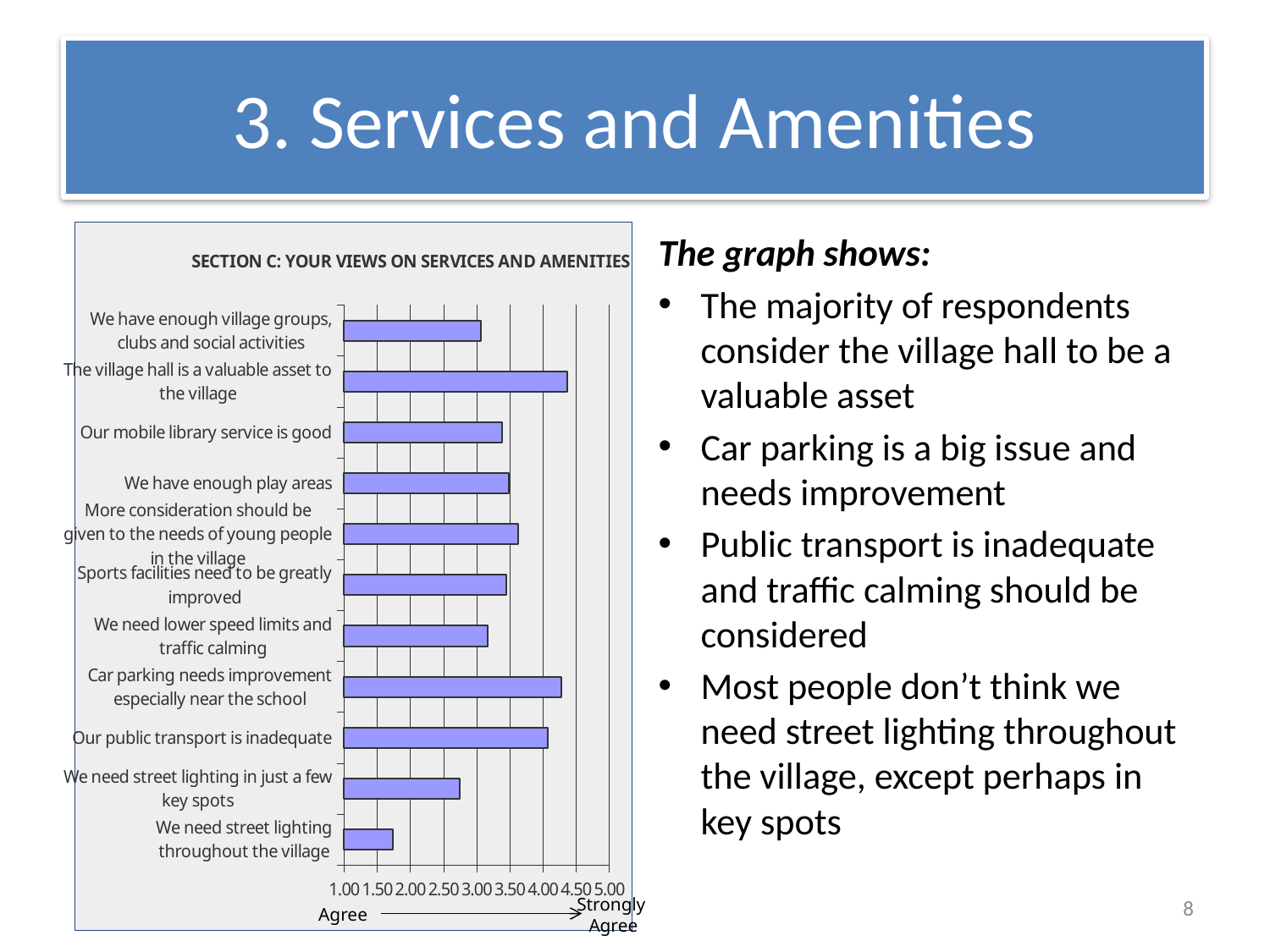
Which statement has the lowest value in the chart? We need street lighting throughout the village Is the value for 'We need lower speed limits and traffic calming' greater or less than 3.50? less What is the title of the chart? SECTION C: YOUR VIEWS ON SERVICES AND AMENITIES Is the value for 'We need street lighting in just a few key spots' greater or less than 3.00? less Which has the larger value: 'Our public transport is inadequate' or 'Our mobile library service is good'? Our public transport is inadequate Is the value for 'The village hall is a valuable asset to the village' greater or less than 4.00? greater Which has the larger value: 'We need street lighting in just a few key spots' or 'We need street lighting throughout the village'? We need street lighting in just a few key spots What do the two ends of the horizontal axis represent, according to the labels below it? Agree and Strongly Agree What kind of chart is shown on the slide? Bar chart How many statements (categories) are plotted in the chart? 11